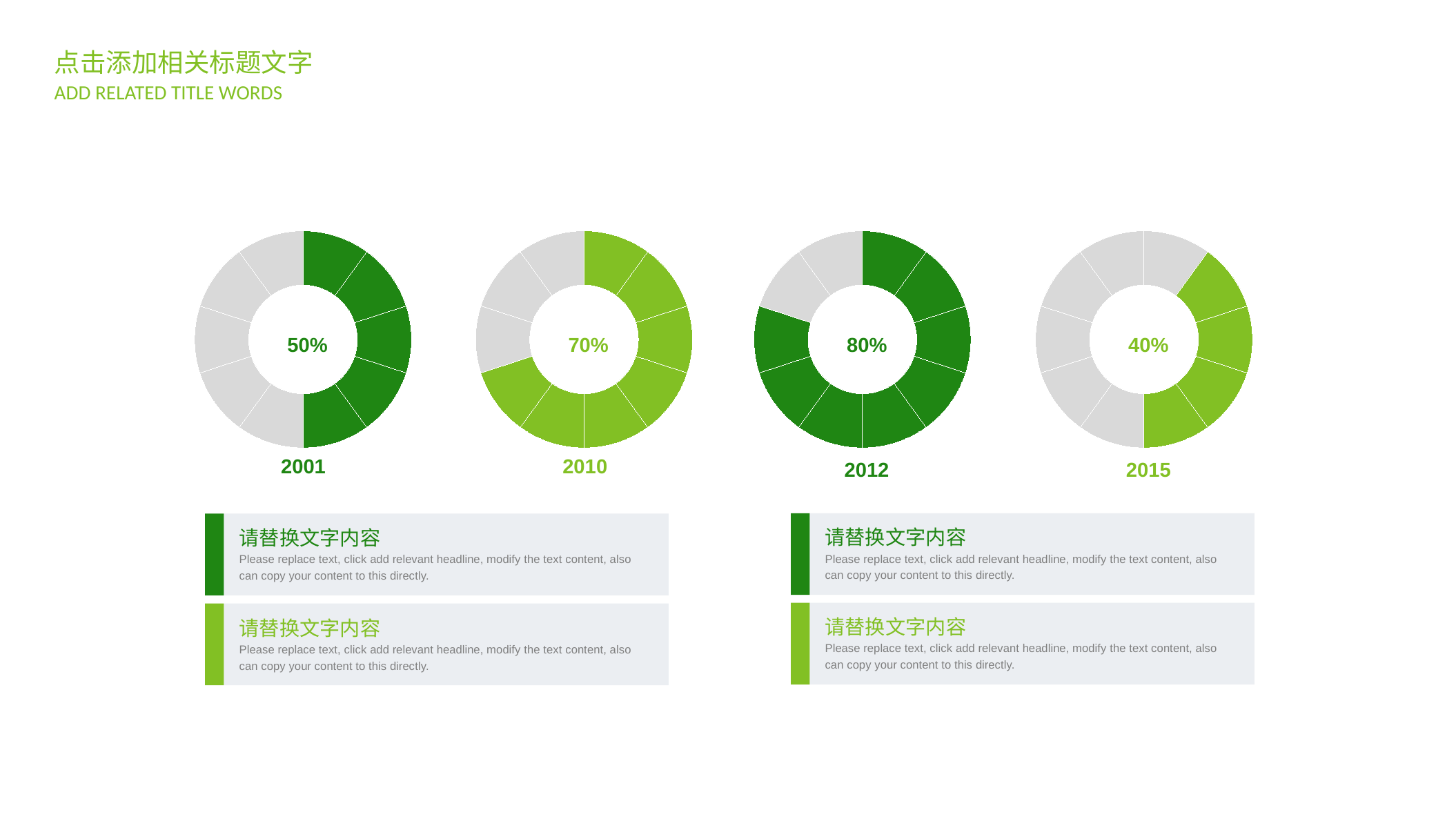
What percentage is shown in the centre of the donut chart labelled 2001? 50% What percentage is shown in the centre of the donut chart labelled 2012? 80% Do the percentages rise or fall from the 2001 chart to the 2012 chart? Rise What kind of chart is used to show the percentage for each year? Donut chart How many donut charts are on the slide? 4 Which is larger, the percentage shown for 2010 or the percentage shown for 2001? 2010 What is the difference between the percentage shown for 2012 and the percentage shown for 2015? 40% What percentage is shown in the centre of the donut chart labelled 2010? 70% What colour is the filled portion of the donut chart labelled 2015? Light green What percentage is shown in the centre of the donut chart labelled 2015? 40% Which year's donut chart shows the highest percentage? 2012 Which year's donut chart shows the lowest percentage? 2015